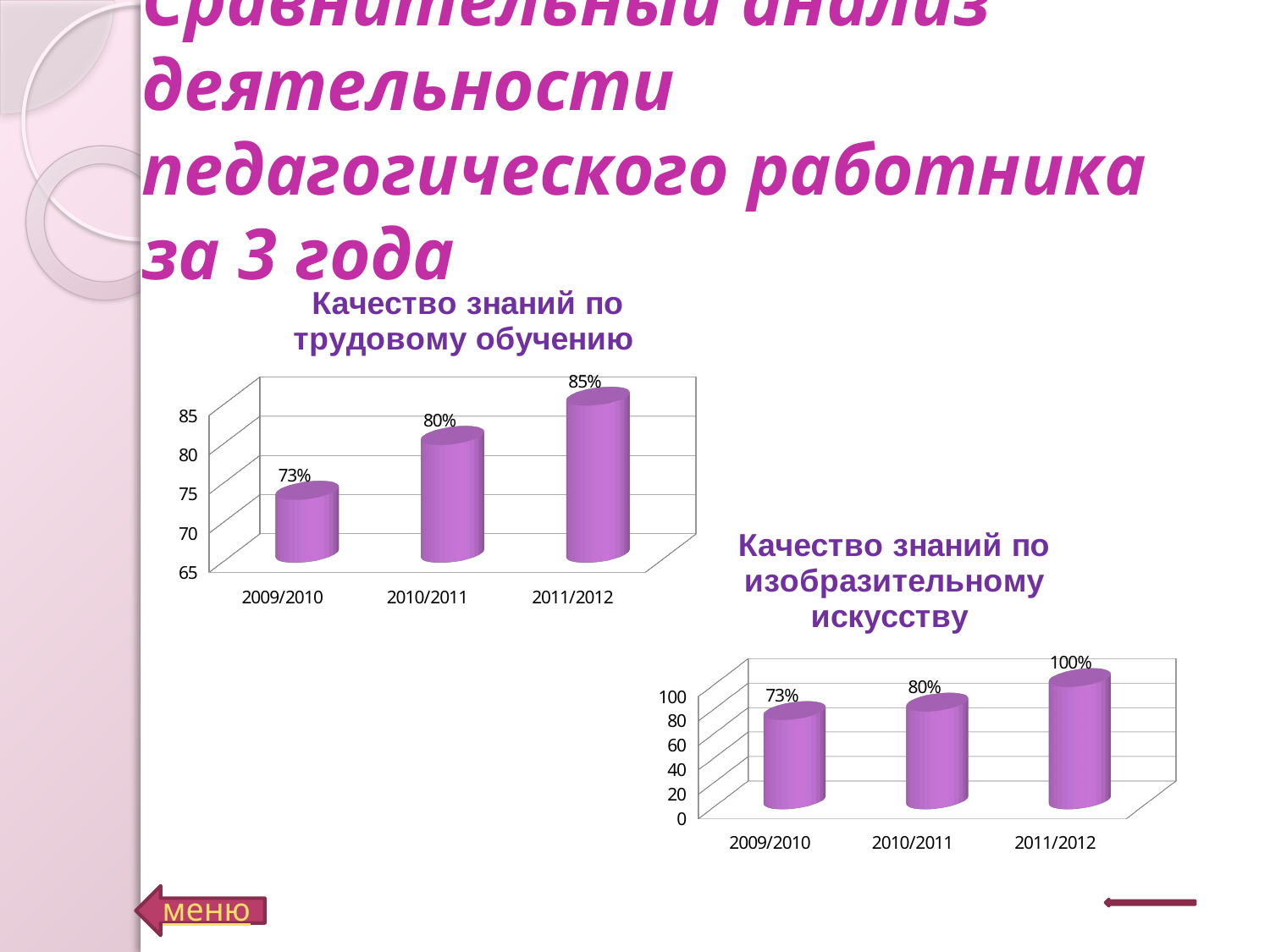
In the chart 'Качество знаний по трудовому обучению', is the value for 2009/2010 greater or less than 75? less In the chart 'Качество знаний по трудовому обучению', how many categories are shown on the x axis? 3 What kind of chart is 'Качество знаний по изобразительному искусству'? bar chart In the chart 'Качество знаний по изобразительному искусству', which is larger, the value for 2010/2011 or 2009/2010? 2010/2011 In the chart 'Качество знаний по изобразительному искусству', which year has the lowest value? 2009/2010 What colour are the bars in the chart 'Качество знаний по трудовому обучению'? purple In the chart 'Качество знаний по трудовому обучению', which year has the highest value? 2011/2012 In the chart 'Качество знаний по трудовому обучению', what is the difference between the values for 2011/2012 and 2009/2010? 12% In the chart 'Качество знаний по трудовому обучению', what is the value for 2010/2011? 80% In the chart 'Качество знаний по изобразительному искусству', what is the value for 2011/2012? 100% In the chart 'Качество знаний по изобразительному искусству', what is the difference between the values for 2011/2012 and 2010/2011? 20% In the chart 'Качество знаний по трудовому обучению', do the values rise or fall from 2009/2010 to 2011/2012? rise